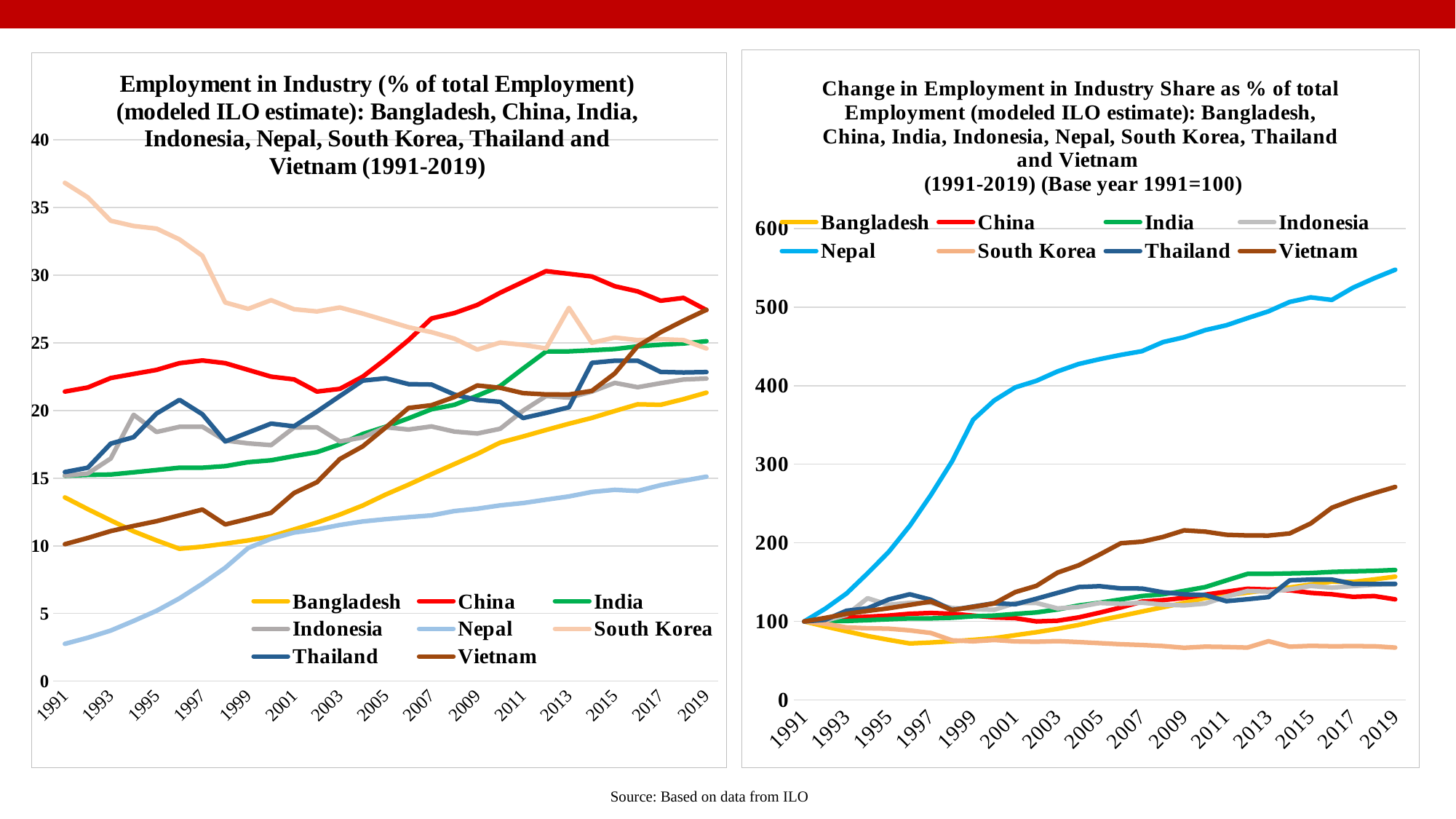
In the right chart, 'Change in Employment in Industry Share', which country has the highest value in 2019? Nepal How many series does the legend of the left chart list? 8 What kind of chart is the left chart, 'Employment in Industry (% of total Employment)'? line chart In the right chart, is the value for Nepal in 2019 greater or less than 500? greater In the right chart, which country has the lowest value in 2019? South Korea In the left chart, which country has the highest employment in industry share in 1991? South Korea In the right chart, is the value for Vietnam in 2019 greater or less than 200? greater In the left chart, is the value for South Korea in 1991 greater or less than 35? greater In the left chart, does the South Korea line generally rise or fall from 1991 to 2019? fall In the right chart, what base year and index value are stated in the title? 1991=100 In the left chart, which country has the lowest employment in industry share in 1991? Nepal